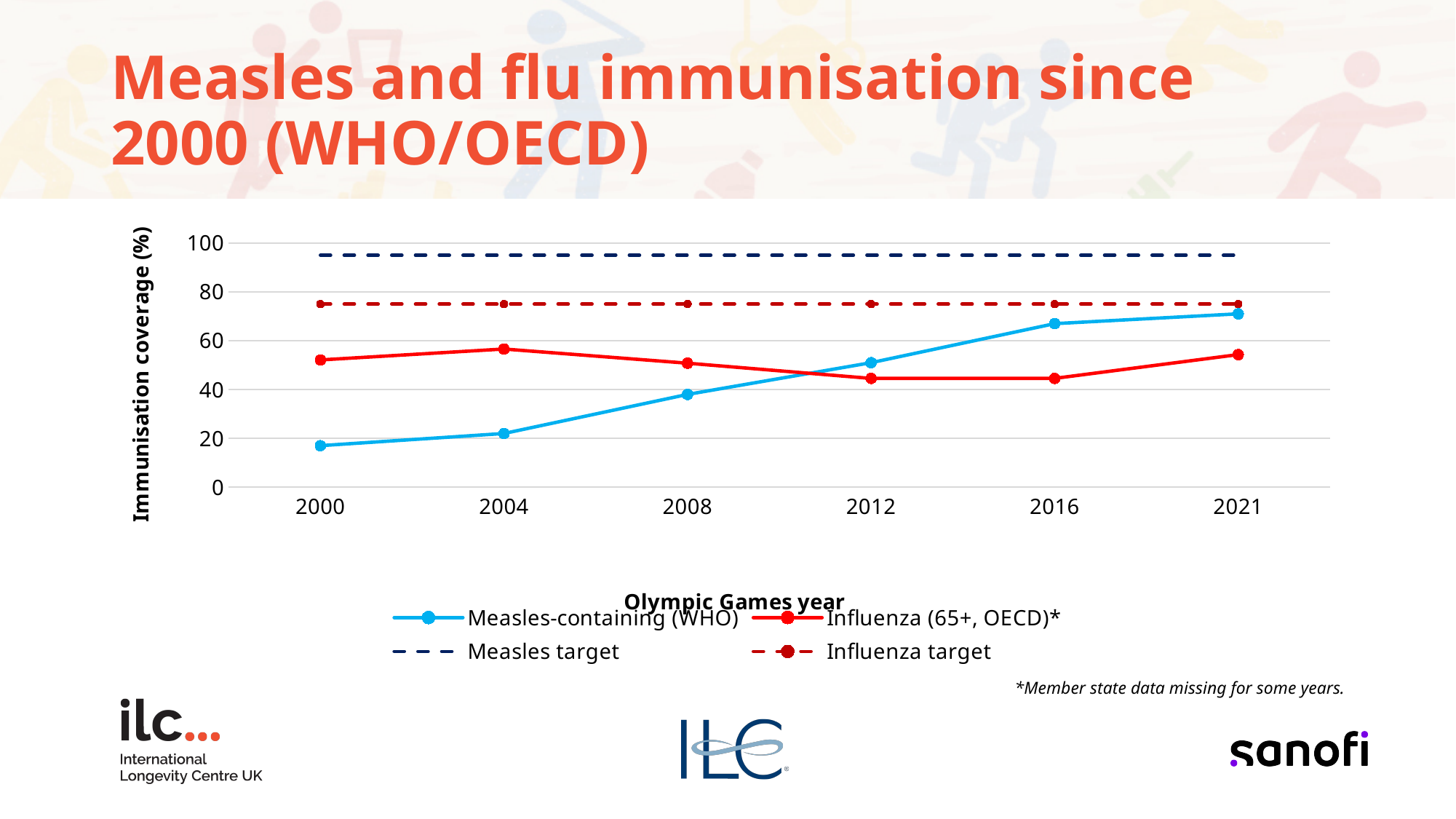
Is the Measles-containing (WHO) value for 2016 greater or less than 60? greater In which year is the Measles-containing (WHO) coverage lowest? 2000 In 2021, which is larger: Measles-containing (WHO) coverage or Influenza (65+, OECD) coverage? Measles-containing (WHO) How many series does the legend list? 4 Is the Measles target line greater or less than 80? greater Does the Measles-containing (WHO) coverage rise or fall from 2000 to 2021? Rise In 2000, which is larger: Measles-containing (WHO) coverage or Influenza (65+, OECD) coverage? Influenza (65+, OECD) What kind of chart is shown on the slide? Line chart How many Olympic Games years are plotted along the x axis? 6 Is the Influenza target line greater or less than 80? less In which year is the Measles-containing (WHO) coverage highest? 2021